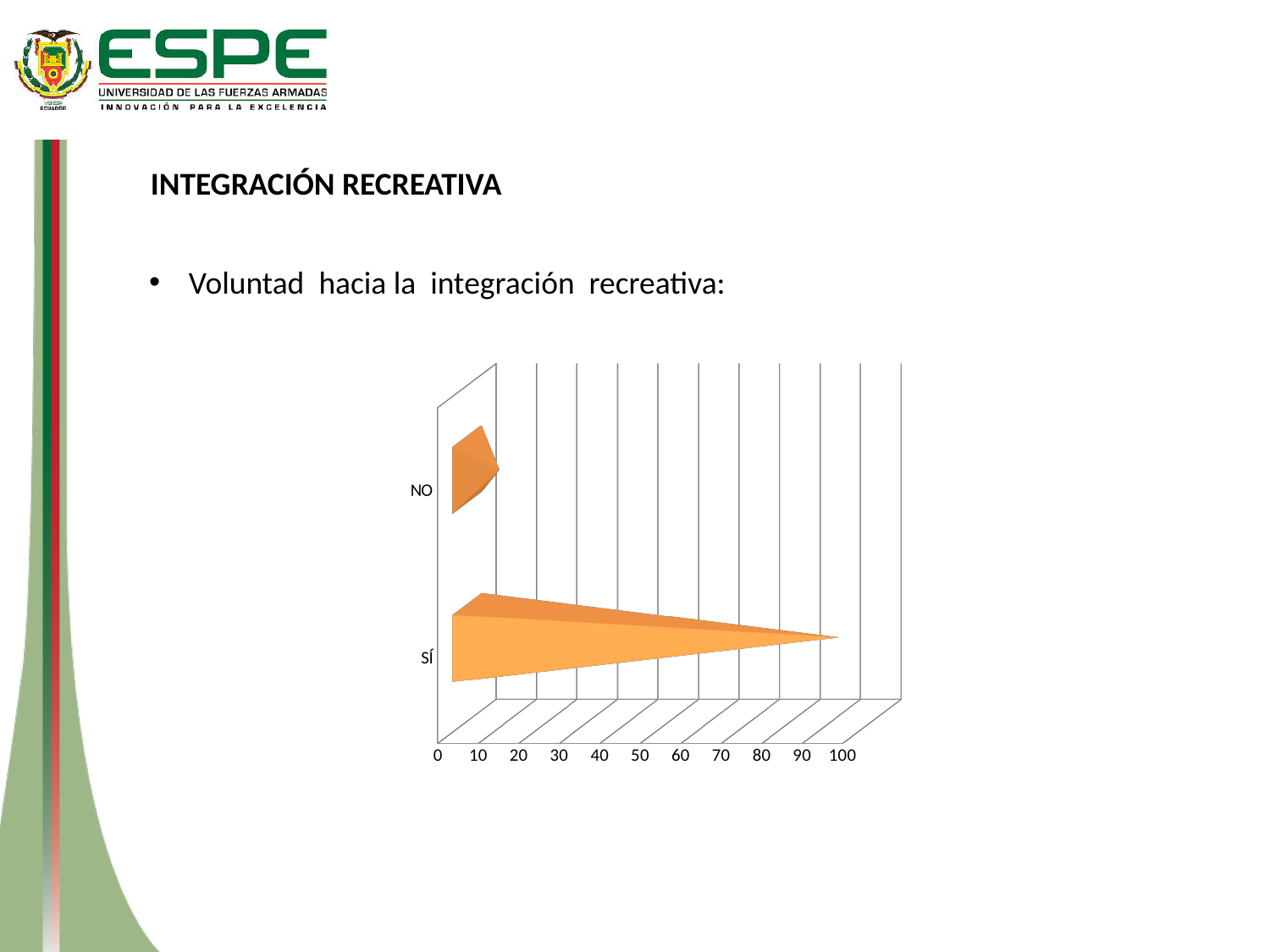
Is the value for NO greater or less than 50? less Is the value for NO greater or less than 30? less What are the two category labels on the chart's vertical axis? NO and SÍ Is the value for SÍ greater or less than 50? greater What is the highest value shown on the horizontal axis of the chart? 100 What kind of chart is shown on the slide? bar chart How many categories are shown on the chart? 2 Which is larger, the value for SÍ or the value for NO? SÍ Which category has the highest value on the chart? SÍ Which category has the lowest value on the chart? NO